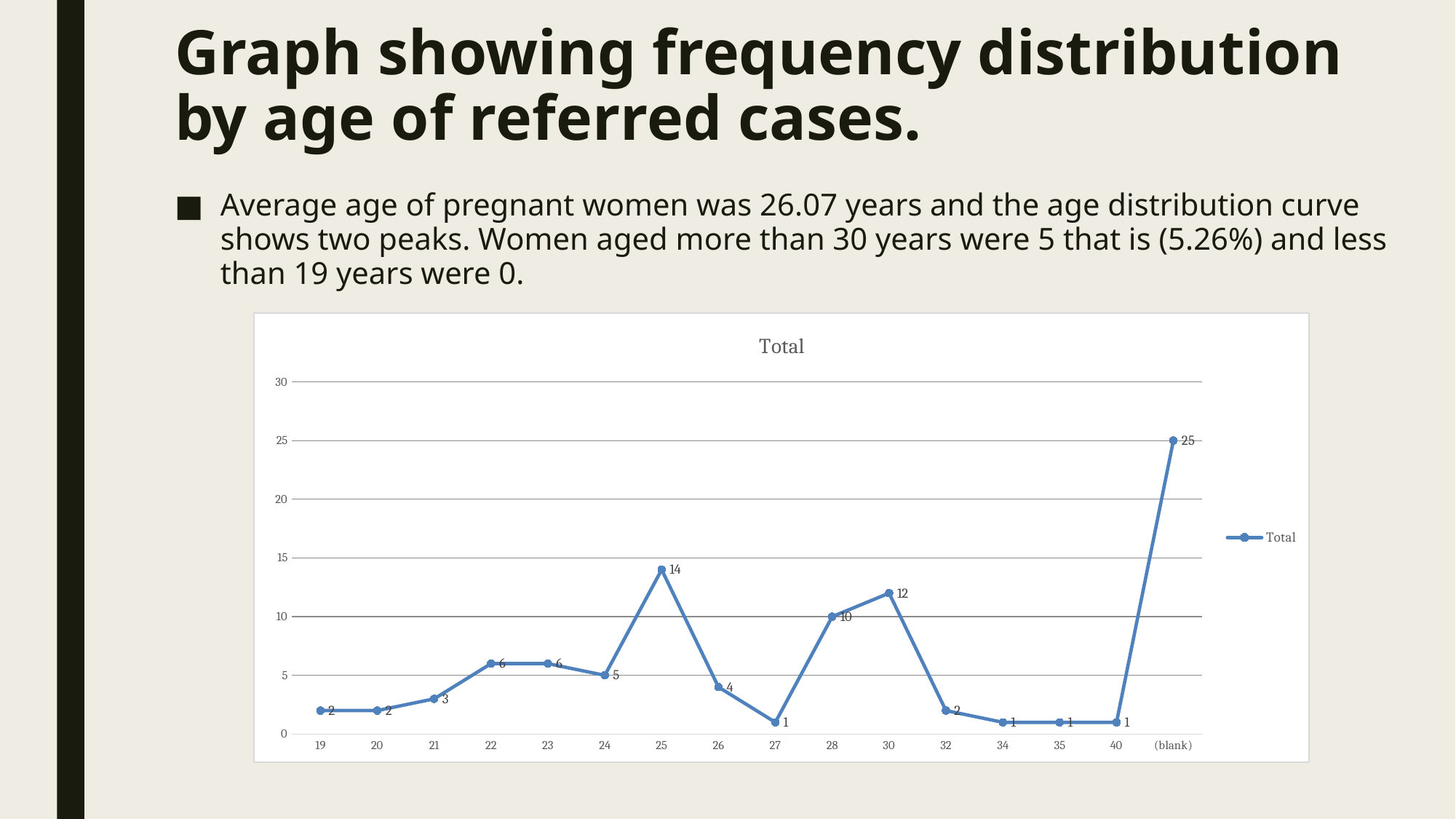
What is the value for the (blank) category? 25 What is the title of the chart? Total What is the difference between the values for age 25 and age 26? 10 What is the value for age 28? 10 What is the value for age 25? 14 What type of chart is shown on the slide? Line chart How many data points are plotted on the line? 16 Which category has the highest value? (blank) Among the numeric age categories, which age has the highest value? 25 How many series does the legend list? 1 What is the value for age 30? 12 Which is larger, the value for age 22 or the value for age 24? Age 22